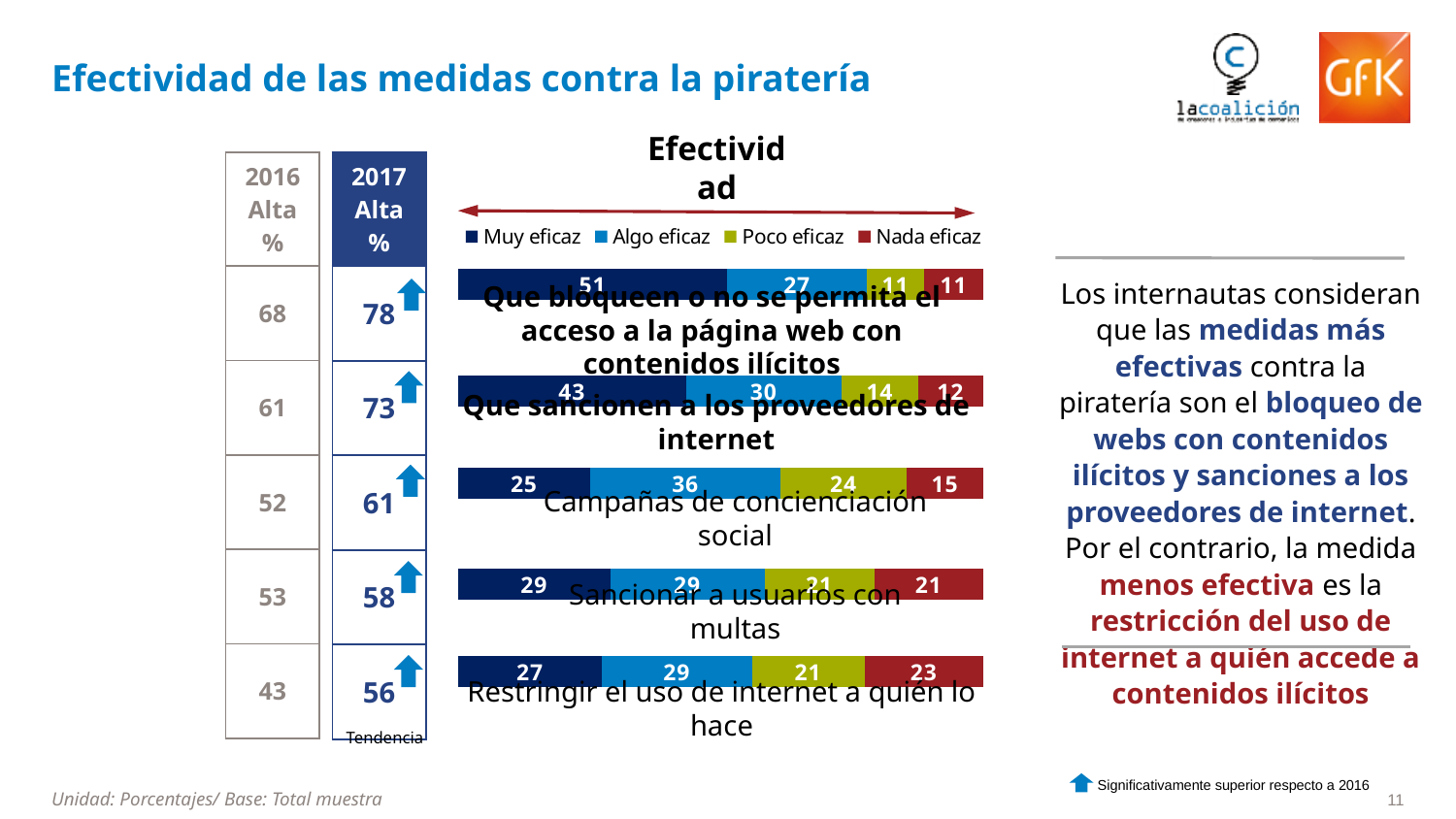
What is the 'Nada eficaz' value for 'Restringir el uso de internet a quién lo hace'? 23 What is the 2017 Alta % value for the measure 'Que sancionen a los proveedores de internet' in the table next to the chart? 73 Which measure has the highest 'Muy eficaz' value? Que bloqueen o no se permita el acceso a la página web con contenidos ilícitos Which is larger: the 'Poco eficaz' value for 'Campañas de concienciación social' or for 'Que sancionen a los proveedores de internet'? Campañas de concienciación social What kind of chart is used to show the effectiveness ratings of the anti-piracy measures? Stacked bar chart Which legend entry is shown in dark blue in the Efectividad chart? Muy eficaz What is the 'Muy eficaz' value for 'Que bloqueen o no se permita el acceso a la página web con contenidos ilícitos'? 51 Which measure has the lowest 'Muy eficaz' value? Campañas de concienciación social What is the difference between the 'Muy eficaz' values for 'Que bloqueen o no se permita el acceso a la página web con contenidos ilícitos' and 'Que sancionen a los proveedores de internet'? 8 How many series does the legend of the Efectividad chart list? 4 What is the 'Algo eficaz' value for 'Campañas de concienciación social'? 36 How many measures (categories) are plotted in the Efectividad chart? 5